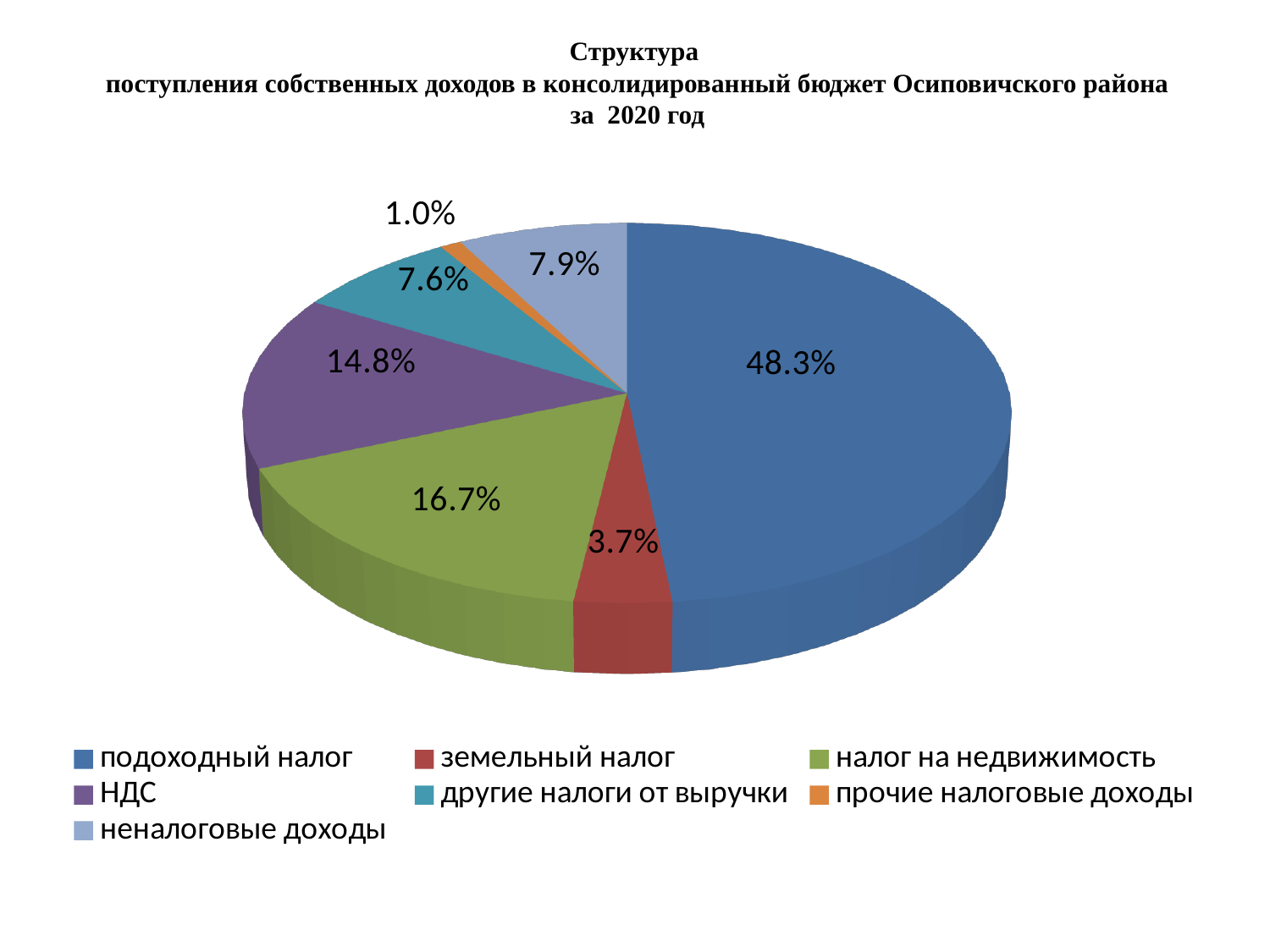
Which category is shown in orange? прочие налоговые доходы What is the difference between the shares of налог на недвижимость and НДС? 1.9% What type of chart is shown on the slide? pie chart Which is larger, the share of другие налоги от выручки or the share of земельный налог? другие налоги от выручки What is the value shown for НДС? 14.8% Which category has the largest share of the pie? подоходный налог What share of the pie does подоходный налог account for? 48.3% What is the value shown for налог на недвижимость? 16.7% What is the value shown for неналоговые доходы? 7.9% What is the value shown for земельный налог? 3.7% How many categories does the legend list? 7 Which category has the smallest share of the pie? прочие налоговые доходы